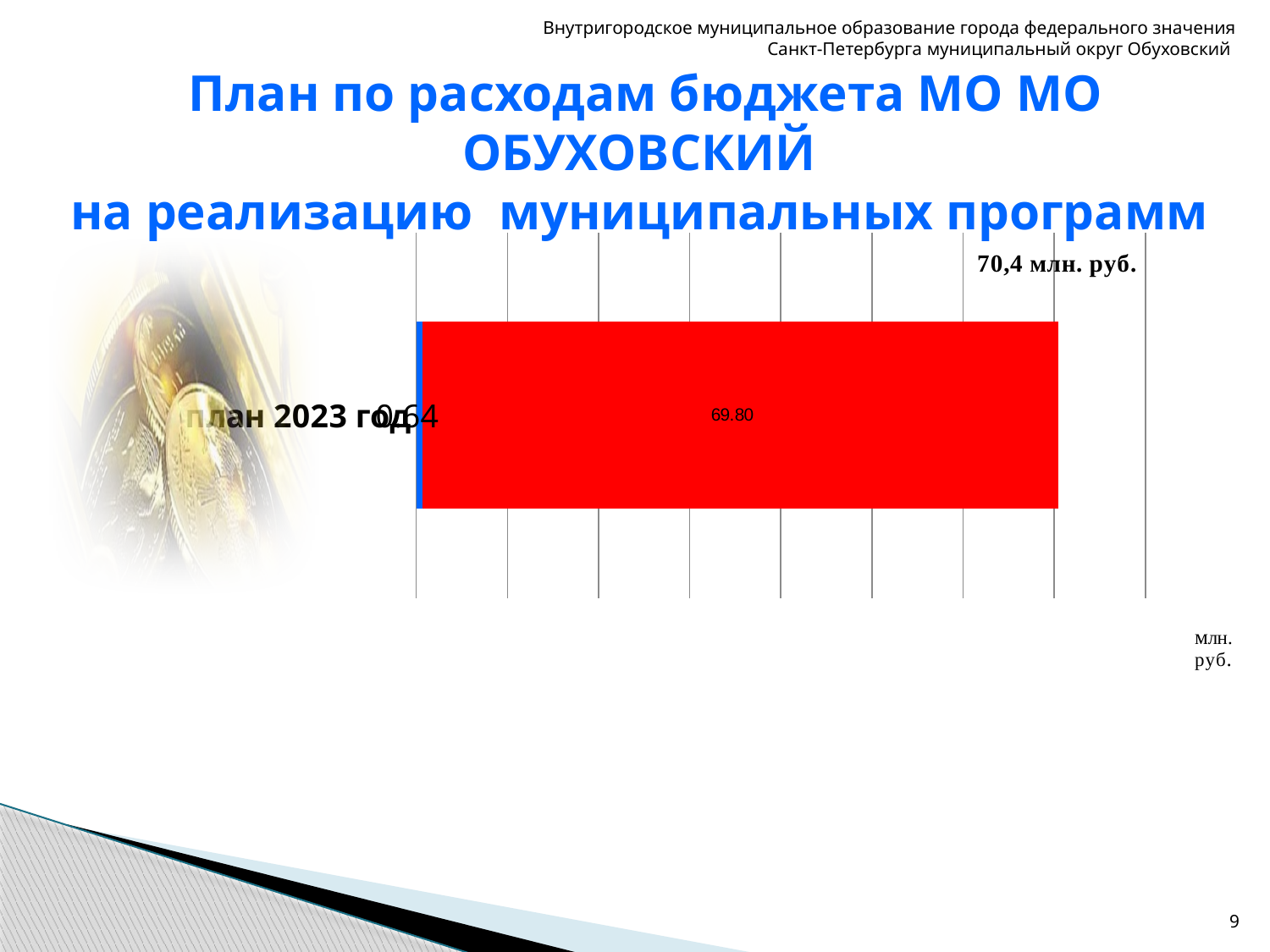
What kind of chart is shown on the slide? bar chart How many categories does the chart show? 1 What is the category label shown on the chart? план 2023 год What value is printed on the red bar for план 2023 год? 69.80 Which bar is longer for план 2023 год, the red one or the blue one? the red one Is the value of the red bar for план 2023 год greater or less than 50? greater What unit is shown at the bottom right of the chart? млн. руб. What total amount is printed above the bar for план 2023 год? 70,4 млн. руб.